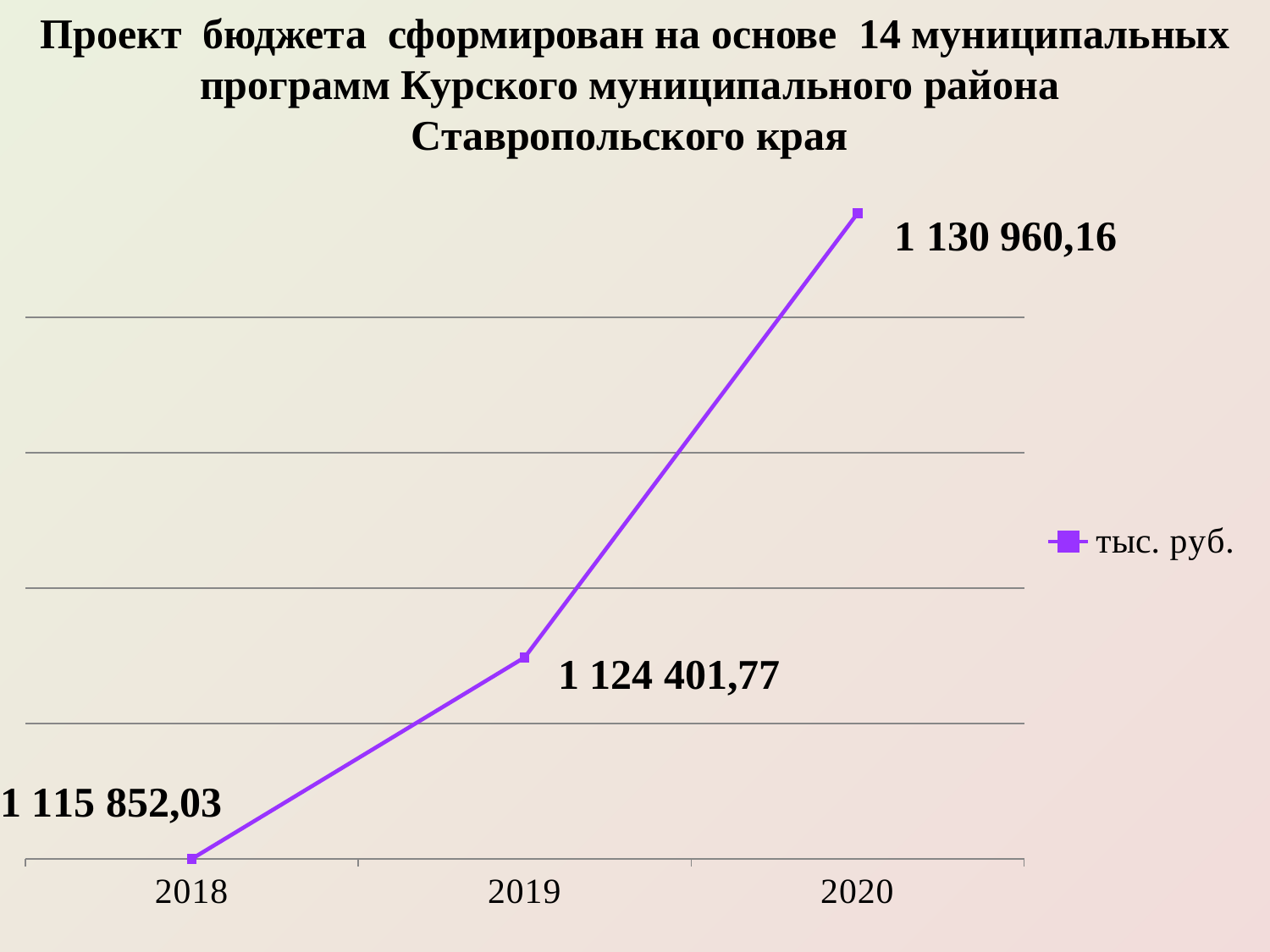
Which is larger, the value for 2019 or the value for 2020? 2020 What is the value for 2020? 1 130 960,16 Which year has the highest value? 2020 What kind of chart is shown on the slide? line chart What is the difference between the values for 2019 and 2018? 8 549,74 Do the values rise or fall from 2018 to 2020? rise What is the value for 2019? 1 124 401,77 How many years are plotted on the chart? 3 What is the difference between the values for 2020 and 2019? 6 558,39 What is the value for 2018? 1 115 852,03 What is the difference between the values for 2020 and 2018? 15 108,13 Which year has the lowest value? 2018